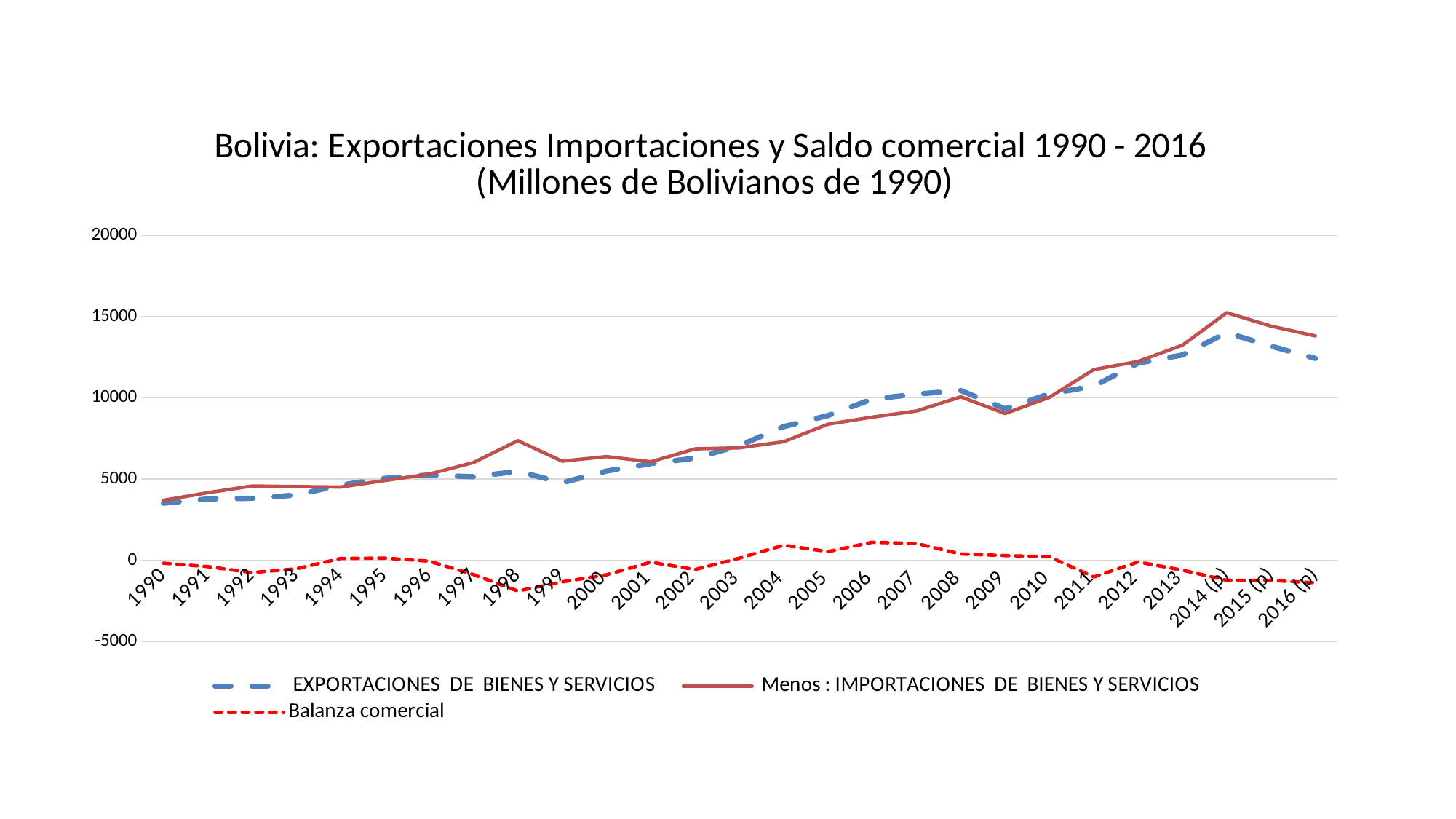
Does the 'EXPORTACIONES DE BIENES Y SERVICIOS' series generally rise or fall from 1990 to 2014 (p)? rise How many series does the legend list? 3 In which year does the 'Balanza comercial' series reach its lowest value? 1998 Is the value for 'Menos : IMPORTACIONES DE BIENES Y SERVICIOS' in 1990 greater or less than 5000? less What is the title of the chart? Bolivia: Exportaciones Importaciones y Saldo comercial 1990 - 2016 (Millones de Bolivianos de 1990) In 1998, which is larger: 'EXPORTACIONES DE BIENES Y SERVICIOS' or 'Menos : IMPORTACIONES DE BIENES Y SERVICIOS'? Menos : IMPORTACIONES DE BIENES Y SERVICIOS Which series is drawn as a red dotted line? Balanza comercial Is the value for 'EXPORTACIONES DE BIENES Y SERVICIOS' in 2014 (p) greater or less than 10000? greater In which year does the 'Menos : IMPORTACIONES DE BIENES Y SERVICIOS' series reach its highest value? 2014 (p) How many years are plotted along the x axis? 27 Is the value for 'Balanza comercial' in 1998 greater or less than 0? less What kind of chart is shown on the slide? line chart